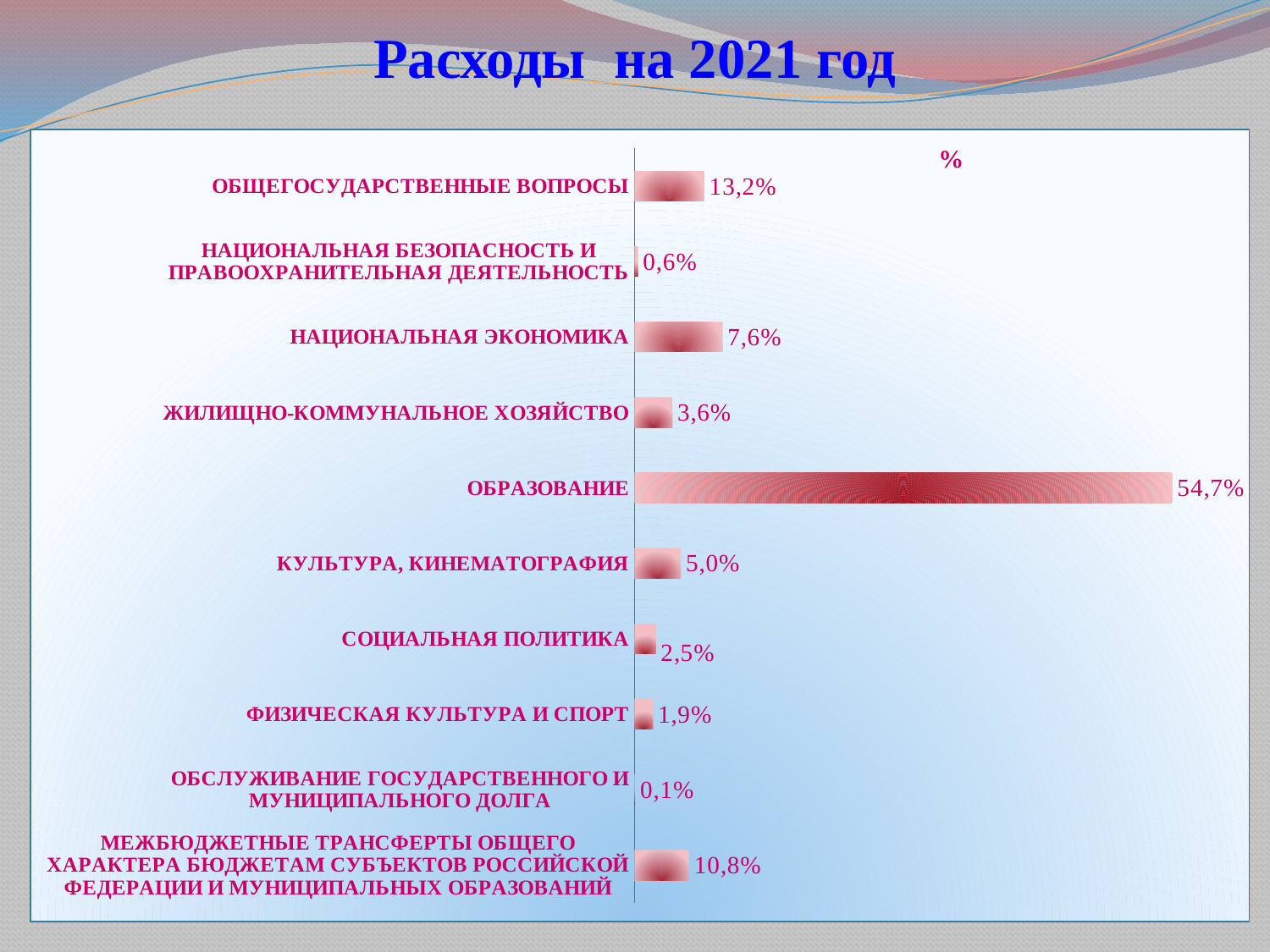
What is the title of the slide? Расходы на 2021 год Which is larger, the value for ЖИЛИЩНО-КОММУНАЛЬНОЕ ХОЗЯЙСТВО or the value for КУЛЬТУРА, КИНЕМАТОГРАФИЯ? КУЛЬТУРА, КИНЕМАТОГРАФИЯ What is the value for ОБЩЕГОСУДАРСТВЕННЫЕ ВОПРОСЫ? 13,2% What kind of chart is shown on the slide? bar chart Which category has the highest value? ОБРАЗОВАНИЕ What is the value for СОЦИАЛЬНАЯ ПОЛИТИКА? 2,5% What is the value for ОБРАЗОВАНИЕ? 54,7% What is the value for ФИЗИЧЕСКАЯ КУЛЬТУРА И СПОРТ? 1,9% Which category has the lowest value? ОБСЛУЖИВАНИЕ ГОСУДАРСТВЕННОГО И МУНИЦИПАЛЬНОГО ДОЛГА What is the difference between the values for ОБЩЕГОСУДАРСТВЕННЫЕ ВОПРОСЫ and НАЦИОНАЛЬНАЯ ЭКОНОМИКА? 5,6% How many categories are shown in the chart? 10 What is the value for НАЦИОНАЛЬНАЯ ЭКОНОМИКА? 7,6%